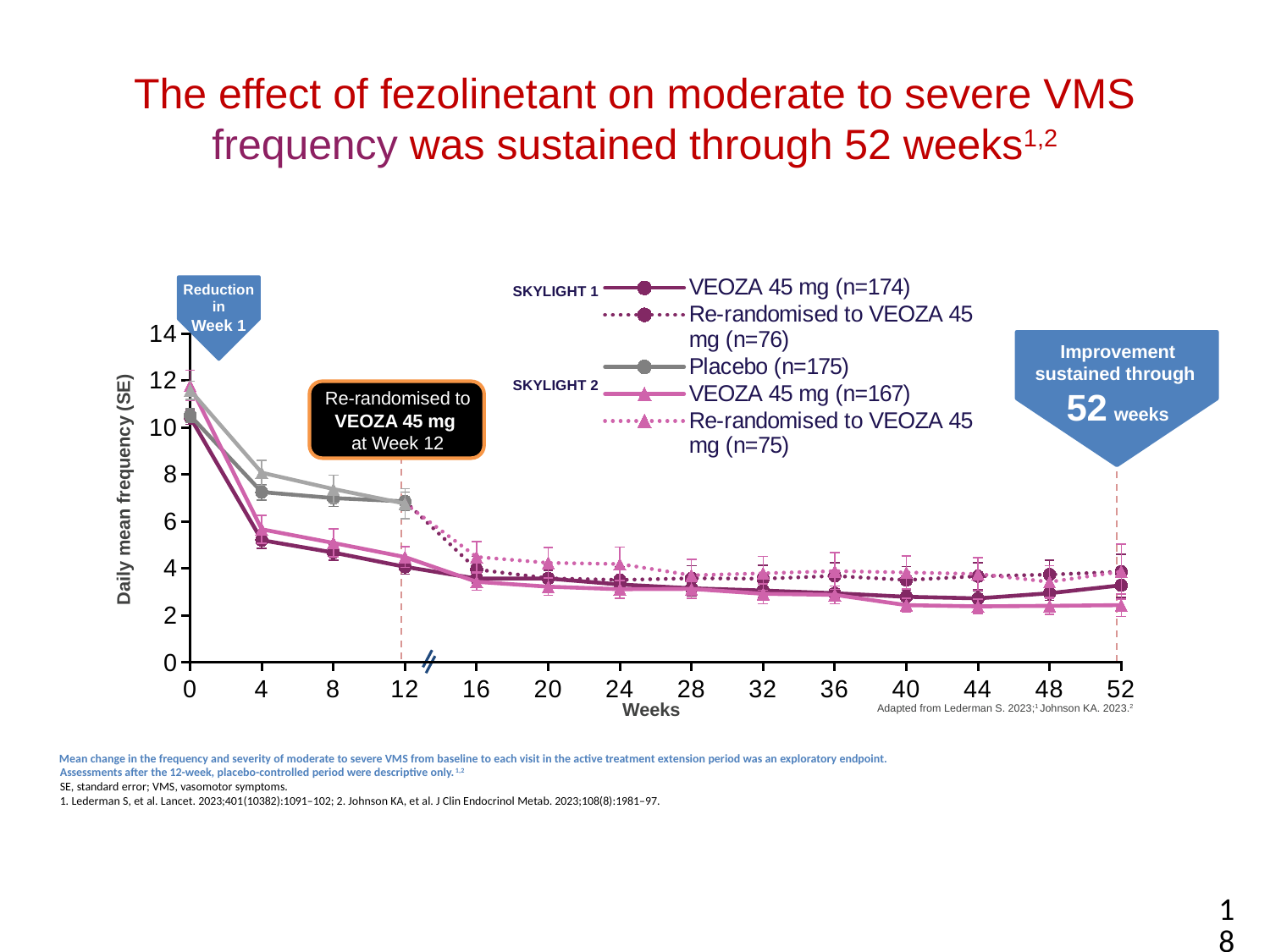
Do the daily mean frequency values rise or fall from week 0 to week 52? fall What is the label of the y axis? Daily mean frequency (SE) Is the value for Placebo (n=175) at week 12 greater or less than 8? less Is the value for VEOZA 45 mg (n=174) at week 4 greater or less than 6? less What is the label of the x axis? Weeks What kind of chart is shown on the slide? line chart How many series does the legend list? 5 Is the value for VEOZA 45 mg (n=167) at week 52 greater or less than 4? less At week 4, which is higher: Placebo (n=175) or VEOZA 45 mg (n=167)? Placebo (n=175) At week 12, which is higher: Placebo (n=175) or VEOZA 45 mg (n=174)? Placebo (n=175)